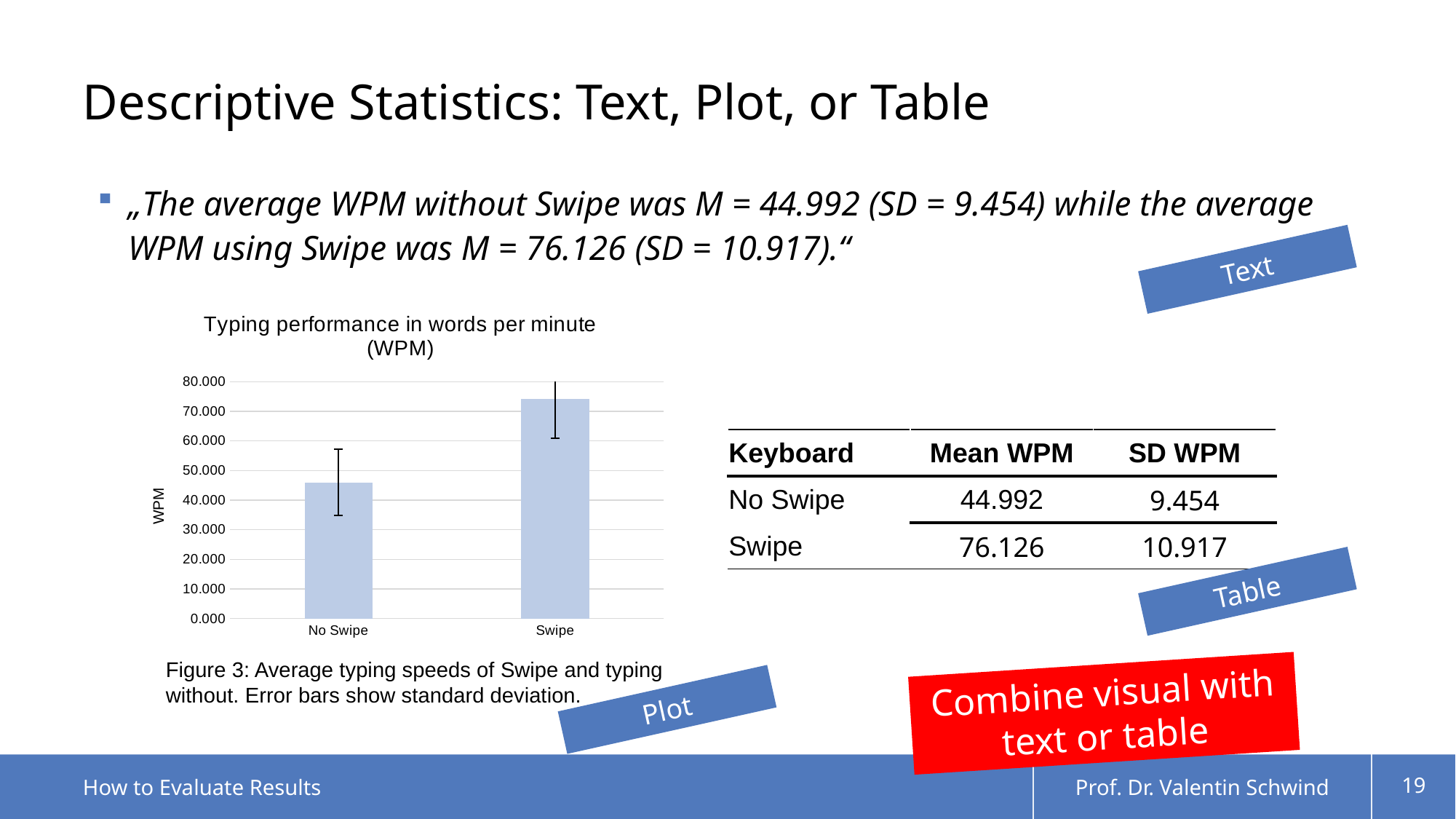
What kind of chart is shown on the slide? bar chart Is the value for Swipe greater or less than 70.000? greater Do the bar values rise or fall from No Swipe to Swipe along the x axis? rise What is the label on the y axis of the chart? WPM Is the value for No Swipe greater or less than 40.000? greater Is the value for No Swipe greater or less than 50.000? less What is the title of the chart? Typing performance in words per minute (WPM) How many categories are plotted on the x axis of the chart? 2 Which category has the lowest bar in the chart? No Swipe Which bar is taller, No Swipe or Swipe? Swipe Which category has the highest bar in the chart? Swipe